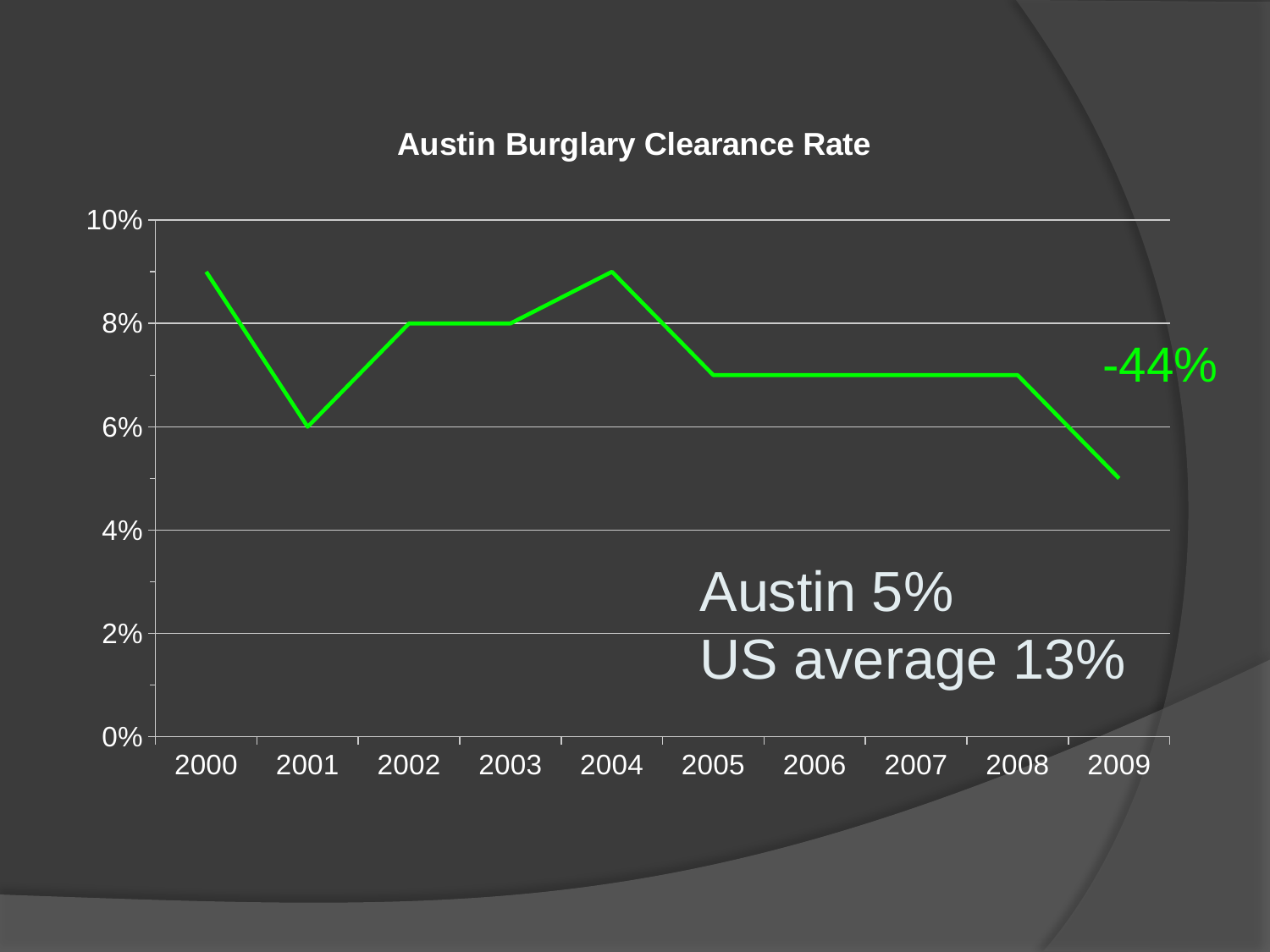
How many years are plotted along the x axis? 10 What is the Austin burglary clearance rate in 2002? 8% What is the Austin burglary clearance rate in 2001? 6% What is the title of the chart? Austin Burglary Clearance Rate Which year has the lowest clearance rate? 2009 What is the Austin burglary clearance rate in 2009? 5% Is the value for 2000 greater or less than 8%? greater Is the value for 2006 greater or less than 8%? less Which is larger, the value for 2002 or the value for 2009? 2002 Does the clearance rate overall rise or fall from 2000 to 2009? fall What kind of chart is shown on the slide? line chart What US average clearance rate is stated on the slide? 13%